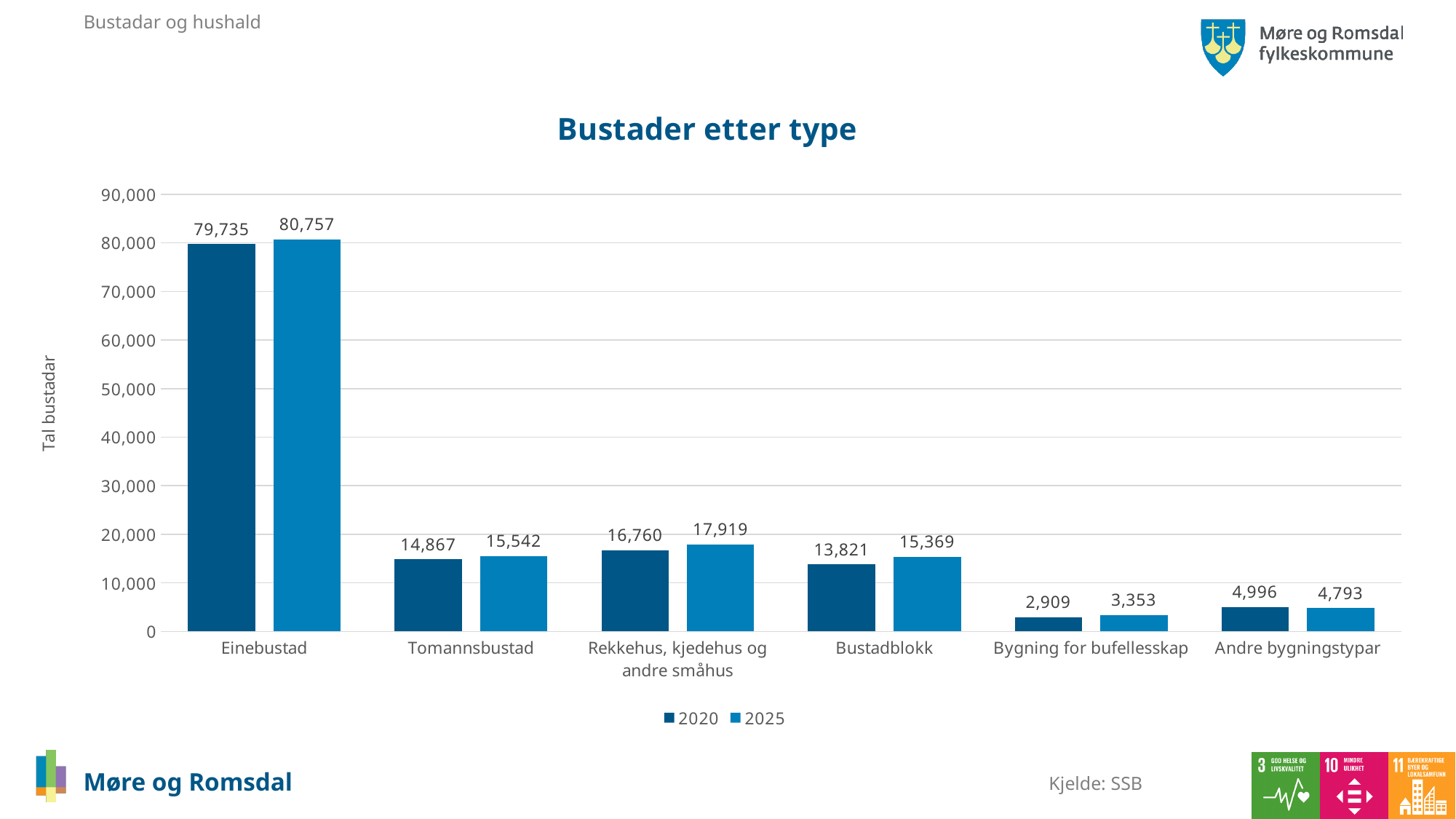
How many series does the legend list? 2 What is the 2025 value for Bustadblokk? 15,369 What is the difference between the 2020 and 2025 values for Andre bygningstypar? 203 How many categories are shown on the x axis? 6 What is the difference between the 2025 and 2020 values for Einebustad? 1,022 Which category has the highest value in 2025? Einebustad Which is larger for Andre bygningstypar: the 2020 value or the 2025 value? 2020 What is the 2025 value for Bygning for bufellesskap? 3,353 What is the title of the chart? Bustader etter type What is the 2020 value for Einebustad? 79,735 Which category has the lowest value in 2020? Bygning for bufellesskap What kind of chart is shown on the slide? Bar chart